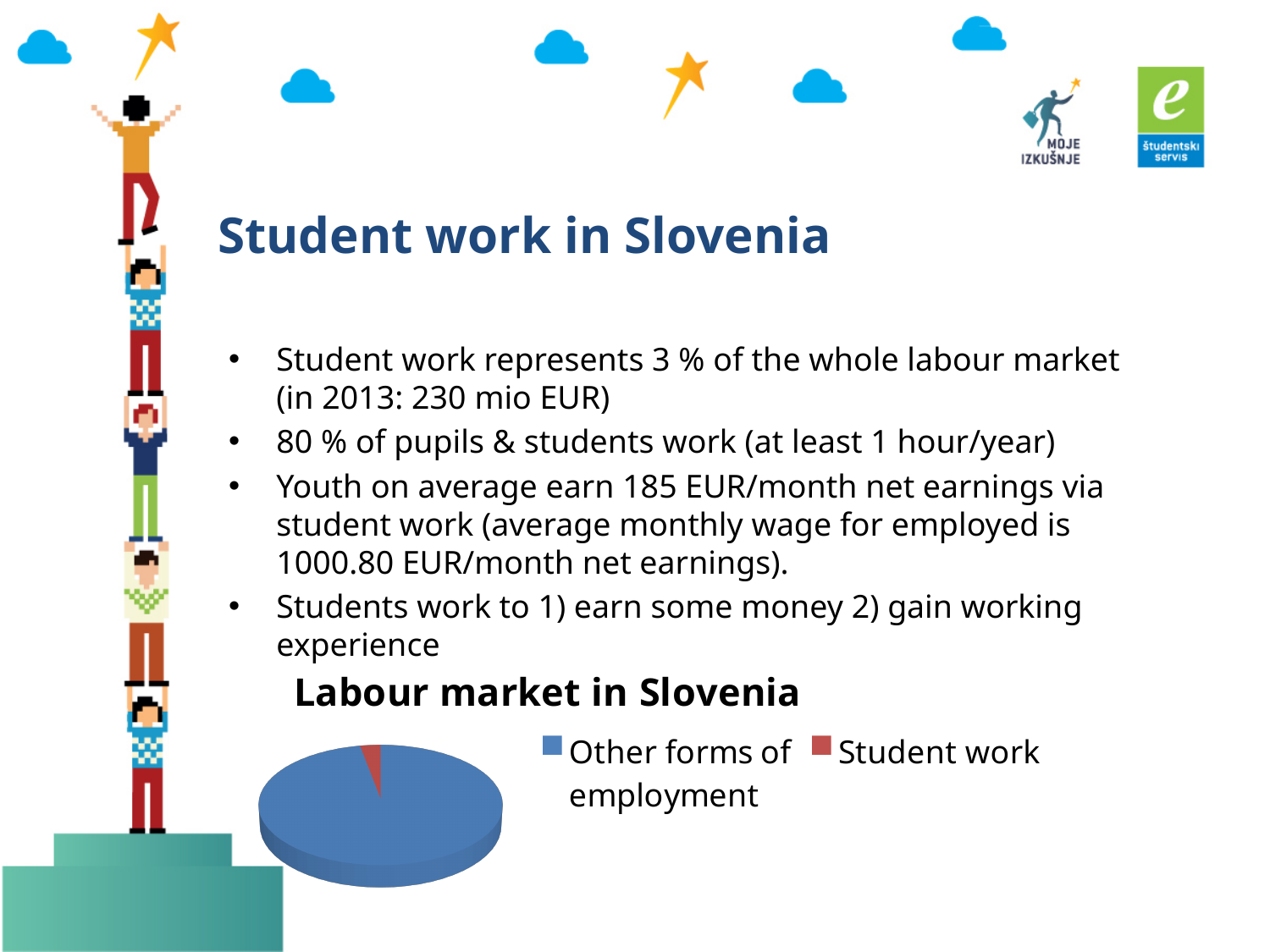
How many slices does the pie chart have? 2 Which slice of the pie chart is the largest? Other forms of employment Which slice of the pie chart is the smallest? Student work What kind of chart is shown on the slide? pie chart What is the title of the chart on the slide? Labour market in Slovenia What colour is the Student work slice in the pie chart? red How many entries does the legend of the pie chart list? 2 In the pie chart, which is larger: Other forms of employment or Student work? Other forms of employment